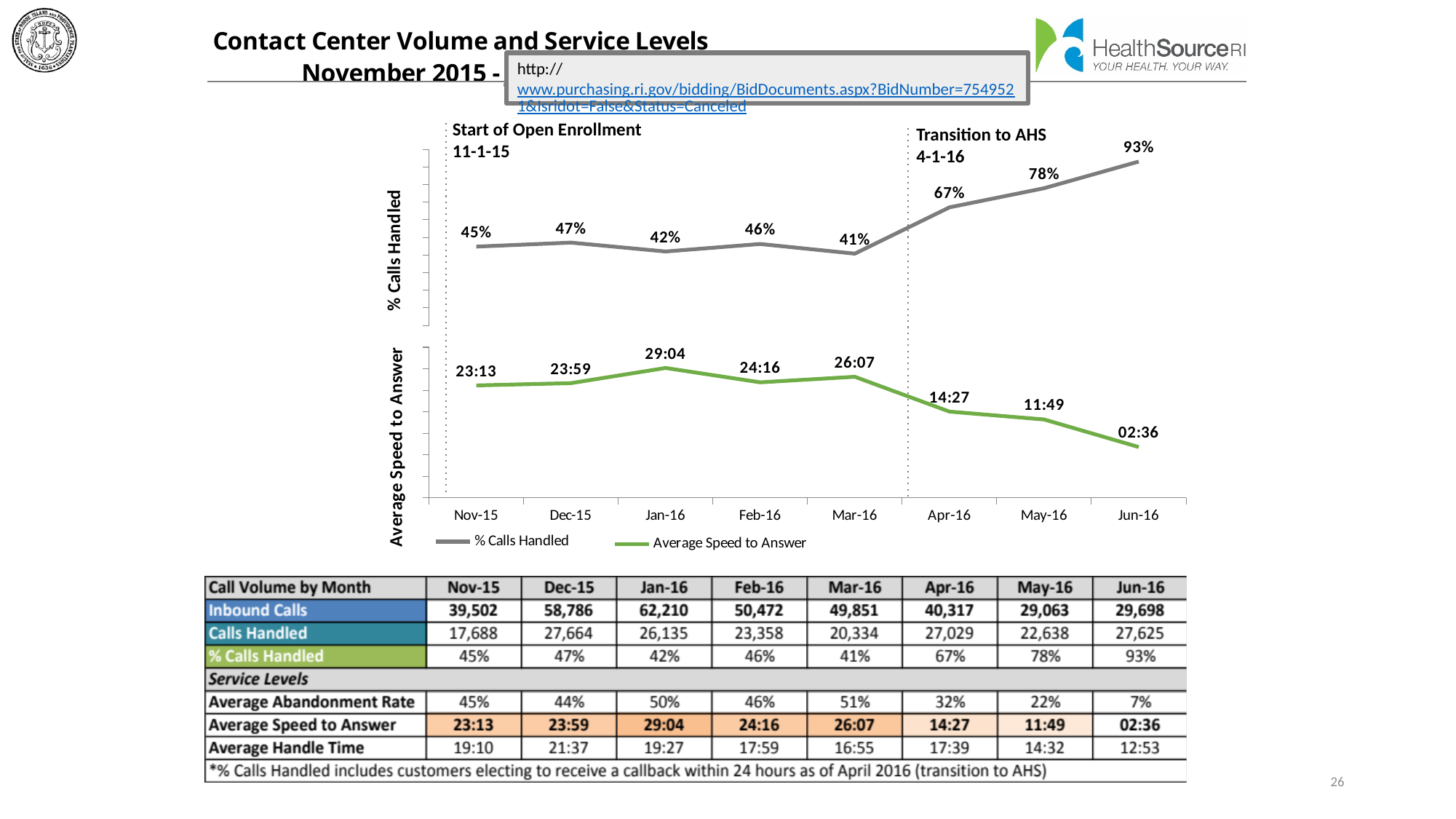
By how many percentage points does % Calls Handled in Jun-16 exceed that in Nov-15? 48 percentage points How many series does the chart's legend list? 2 Which month has a higher % Calls Handled, Dec-15 or Feb-16? Dec-15 What is the % Calls Handled value for Jun-16? 93% In which month is % Calls Handled the highest? Jun-16 In which month is the Average Speed to Answer the lowest? Jun-16 Does the Average Speed to Answer rise or fall from Mar-16 to Jun-16? Fall In which month is % Calls Handled the lowest? Mar-16 What kind of chart is shown on the slide? Line chart How many months are plotted along the x axis of the chart? 8 What is the Average Speed to Answer for Jan-16? 29:04 What event does the dotted line between Mar-16 and Apr-16 mark? Transition to AHS 4-1-16